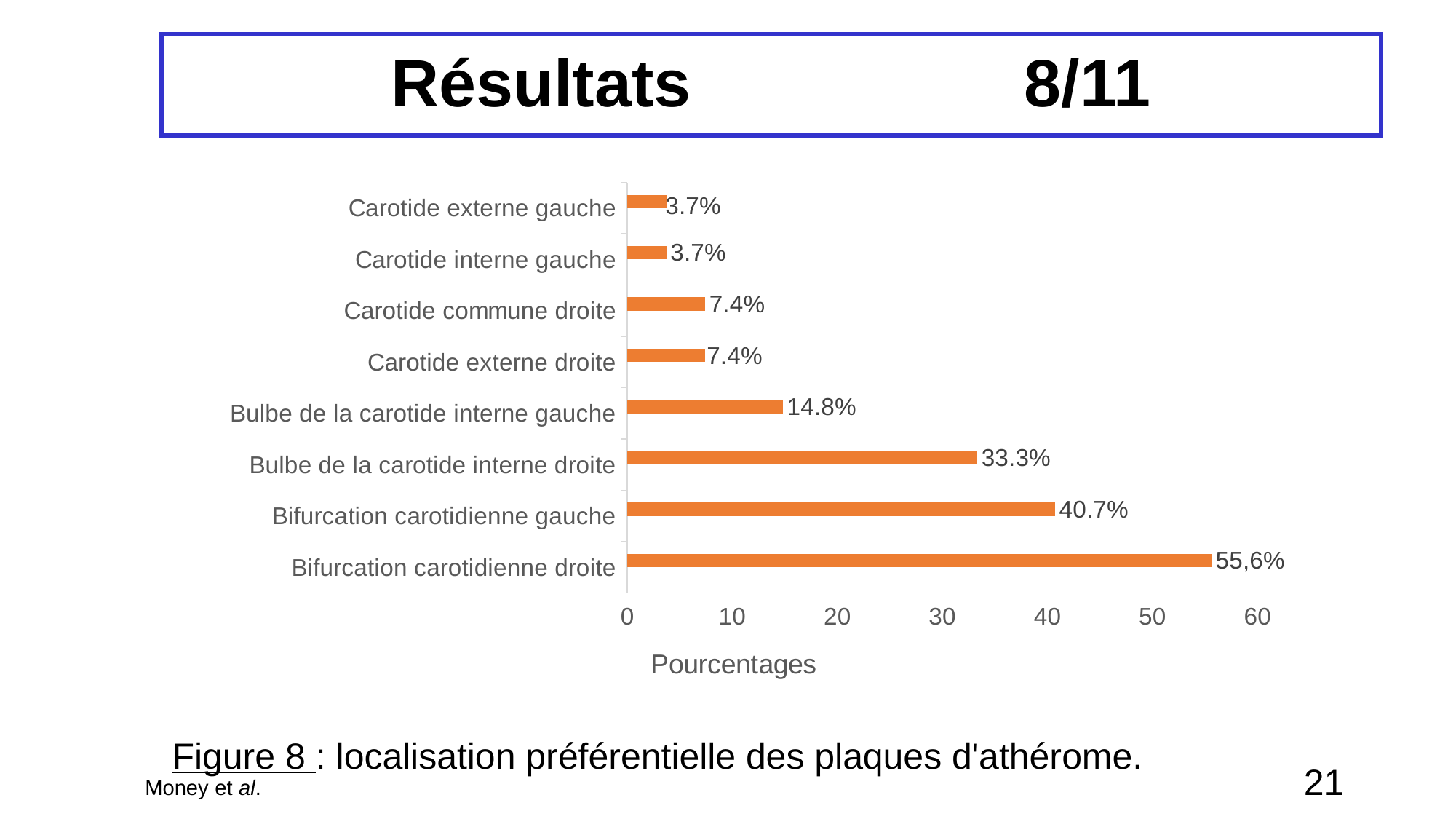
What is the difference between the value for Bulbe de la carotide interne gauche and the value for Carotide externe droite? 7.4% How many categories are shown in the chart? 8 What is the value for Bifurcation carotidienne droite? 55,6% What is the value for Bulbe de la carotide interne droite? 33.3% What is the label of the horizontal axis? Pourcentages Which is larger, the value for Bulbe de la carotide interne droite or the value for Bulbe de la carotide interne gauche? Bulbe de la carotide interne droite Is the value for Bifurcation carotidienne gauche greater or less than 40? greater What is the value for Bulbe de la carotide interne gauche? 14.8% What is the value for Carotide commune droite? 7.4% What type of chart is shown on the slide? bar chart What is the value for Bifurcation carotidienne gauche? 40.7% Which category has the highest value? Bifurcation carotidienne droite